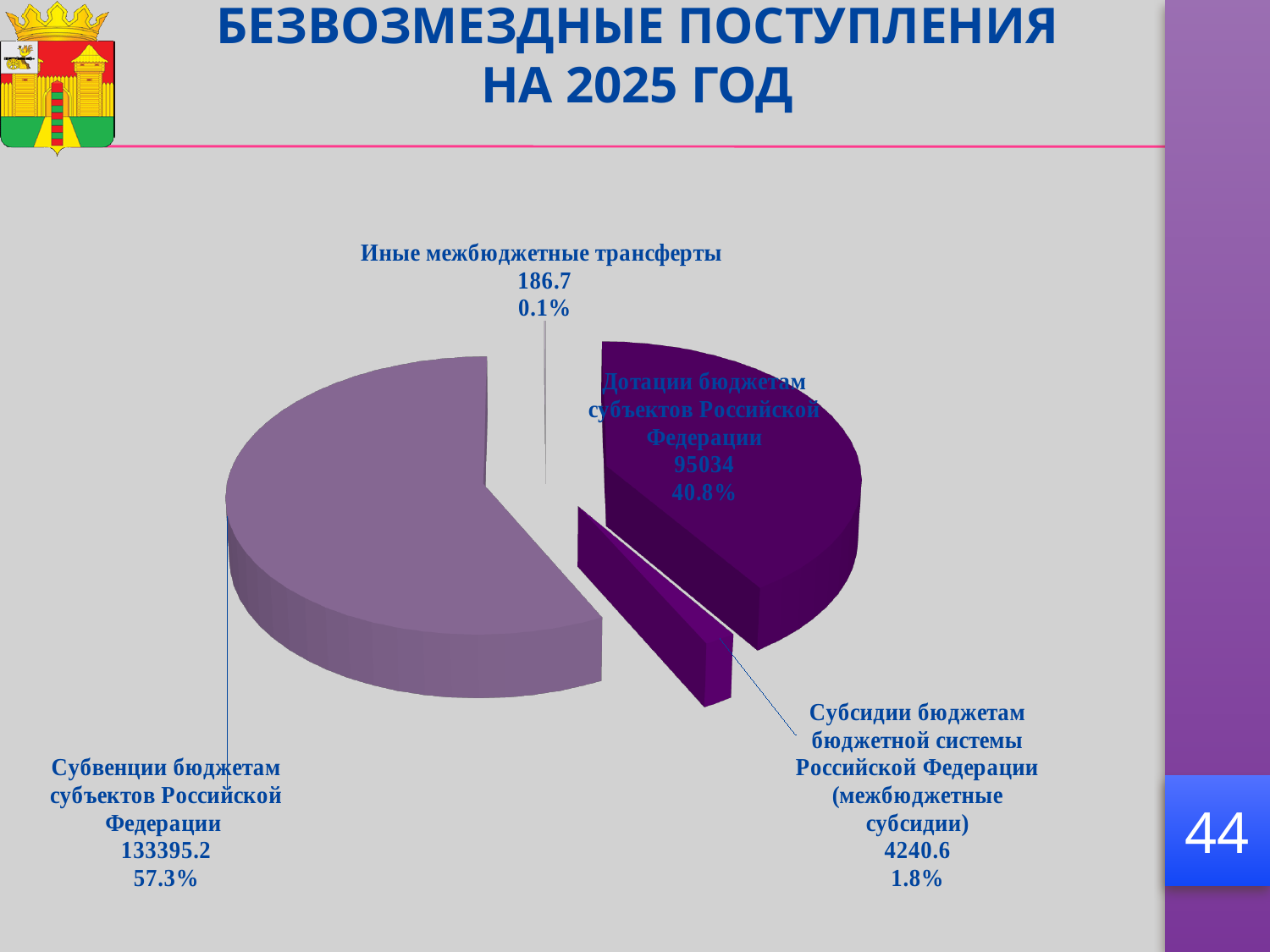
What kind of chart is shown on the slide? Pie chart How many categories are shown in the pie chart? 4 What is the difference between the values for Субвенции бюджетам субъектов Российской Федерации and Дотации бюджетам субъектов Российской Федерации? 38361.2 What value is shown for Субвенции бюджетам субъектов Российской Федерации? 133395.2 Which category has the smallest slice of the pie? Иные межбюджетные трансферты What value is shown for Субсидии бюджетам бюджетной системы Российской Федерации (межбюджетные субсидии)? 4240.6 What value is shown for Дотации бюджетам субъектов Российской Федерации? 95034 Which is larger: the value for Субсидии (межбюджетные субсидии) or the value for Иные межбюджетные трансферты? Субсидии (межбюджетные субсидии) Which category has the largest slice of the pie? Субвенции бюджетам субъектов Российской Федерации What is the title of the slide containing the chart? БЕЗВОЗМЕЗДНЫЕ ПОСТУПЛЕНИЯ НА 2025 ГОД What value is shown for Иные межбюджетные трансферты? 186.7 What share of the pie does Дотации бюджетам субъектов Российской Федерации represent? 40.8%